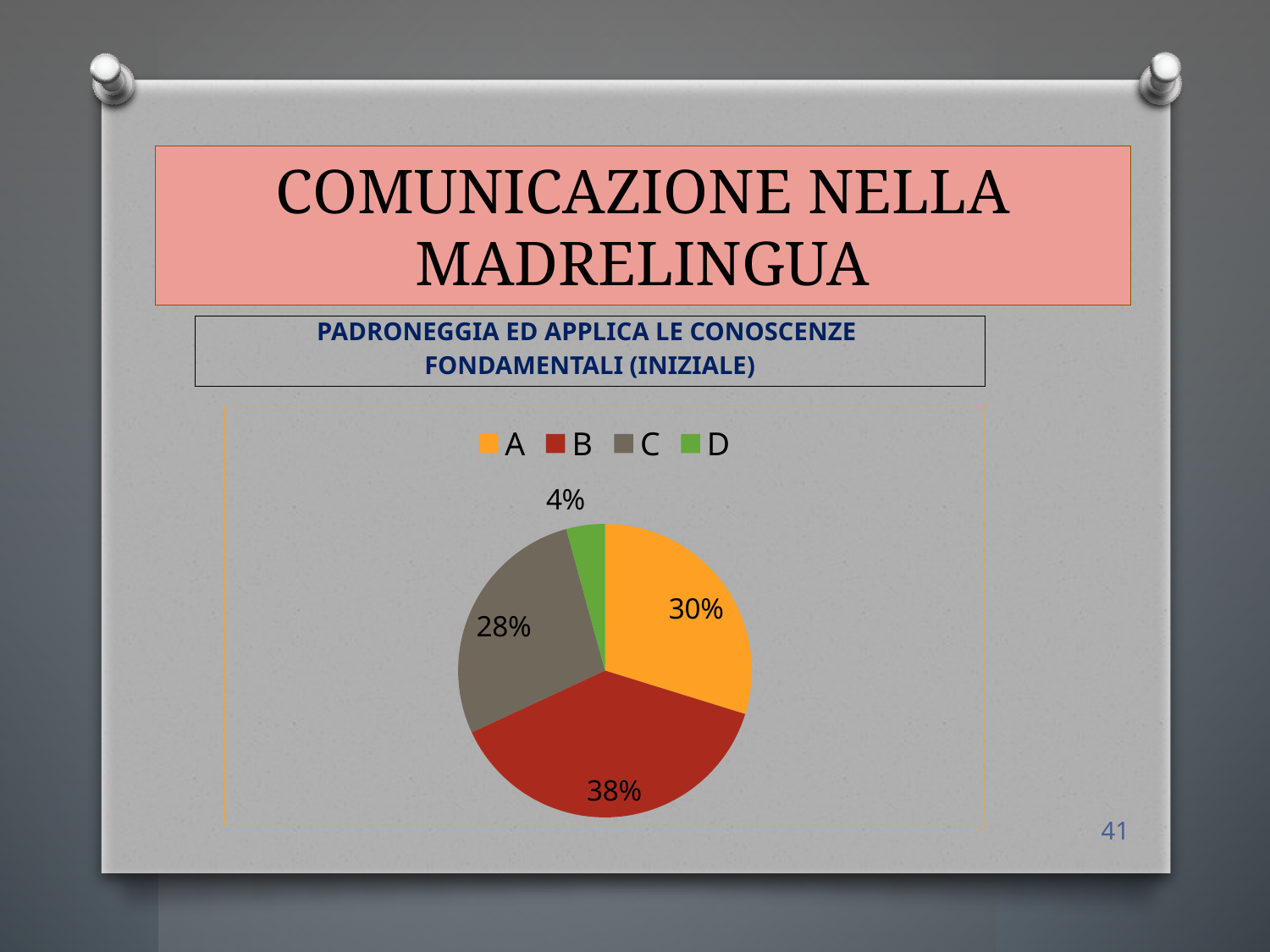
What percentage of the pie does category D represent? 4% What percentage of the pie does category B represent? 38% How many entries does the legend list? 4 What kind of chart is shown on the slide? pie chart Which category has the largest share of the pie? B Which is larger, the share for A or the share for C? A Which category has the smallest share of the pie? D What is the difference in percentage points between category B and category A? 8 What percentage of the pie does category A represent? 30% What colour is the slice for category B? red What percentage of the pie does category C represent? 28% How many categories does the pie chart have? 4